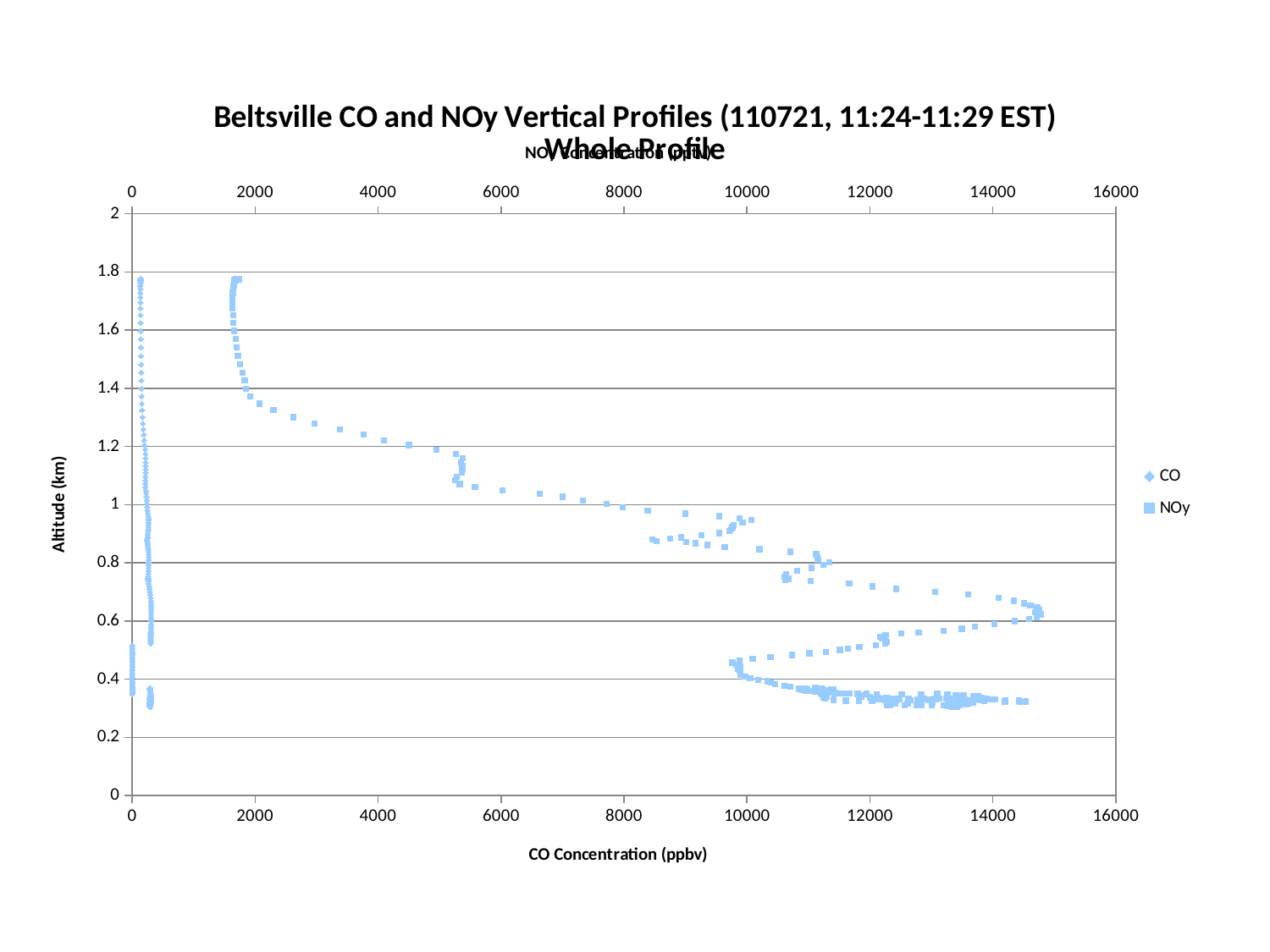
Is the highest altitude reached by the CO series greater or less than 1.6 km? greater Is the CO concentration at an altitude of 1 km greater or less than 2000? less Is the NOy concentration at an altitude of 1.6 km greater or less than 4000? less What kind of chart is shown on the slide? scatter chart What are the two series named in the legend? CO and NOy Between altitudes of 1.2 km and 1.8 km, does the NOy concentration increase or decrease as altitude increases? decrease At an altitude of 1 km, which series has the larger concentration, CO or NOy? NOy How many series does the legend list? 2 What is the title of the vertical axis? Altitude (km)